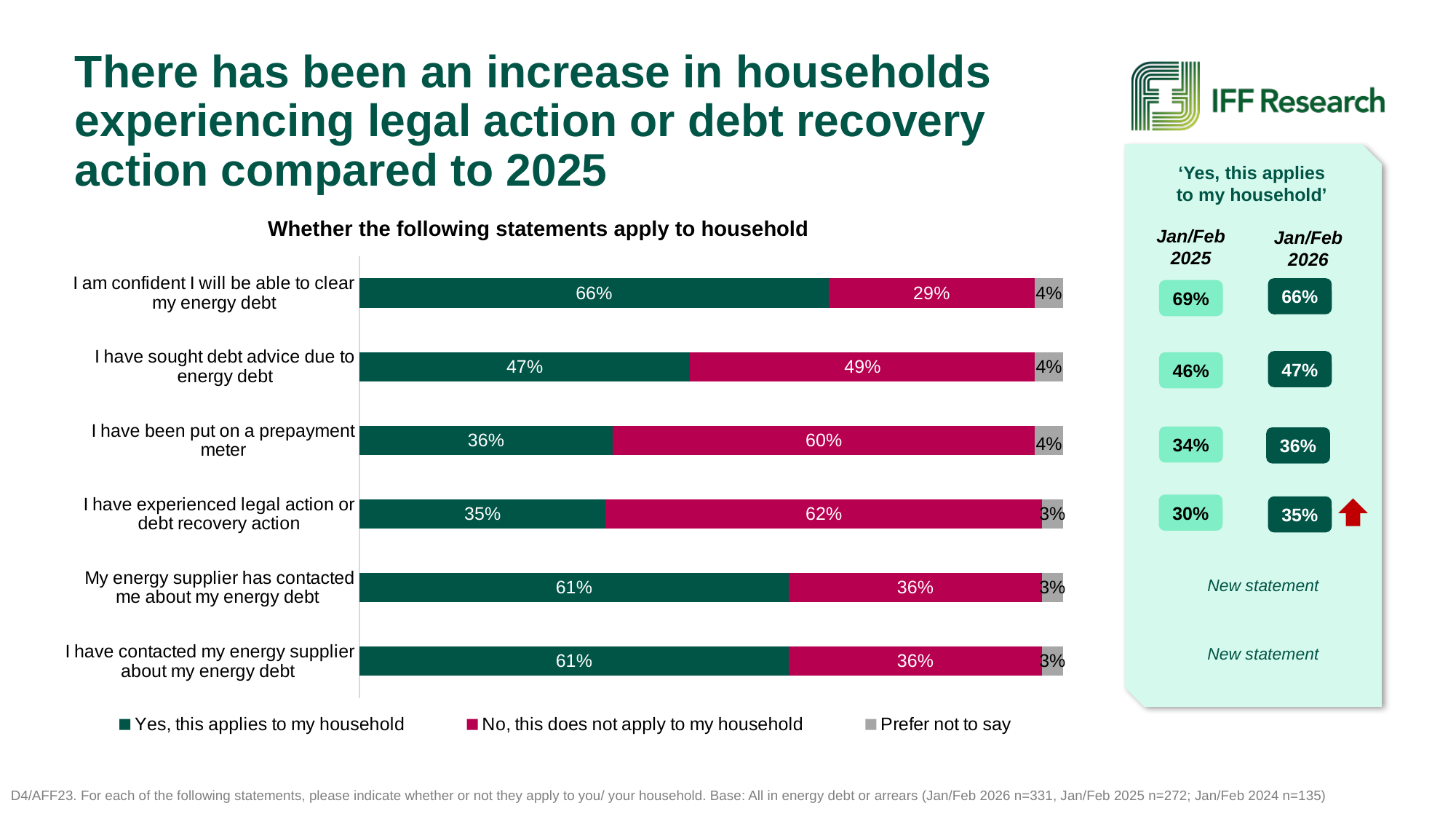
What percentage of households say 'Yes, this applies to my household' for 'I am confident I will be able to clear my energy debt'? 66% How many statements are shown in the chart? 6 Which is larger: the 'Yes' percentage for 'I have been put on a prepayment meter' or the 'Yes' percentage for 'I have sought debt advice due to energy debt'? I have sought debt advice due to energy debt What kind of chart is shown on the slide? Stacked bar chart What is the title of the chart? Whether the following statements apply to household What percentage of households answered 'Prefer not to say' for 'I have experienced legal action or debt recovery action'? 3% What percentage of households say 'No, this does not apply to my household' for 'I have been put on a prepayment meter'? 60% How many series does the legend list? 3 What is the difference between the 'Yes' and 'No' percentages for 'I have sought debt advice due to energy debt'? 2 percentage points What is the total of the stacked bar for 'My energy supplier has contacted me about my energy debt'? 100% Which statement has the highest 'Yes, this applies to my household' percentage? I am confident I will be able to clear my energy debt Which statement has the lowest 'Yes, this applies to my household' percentage? I have experienced legal action or debt recovery action